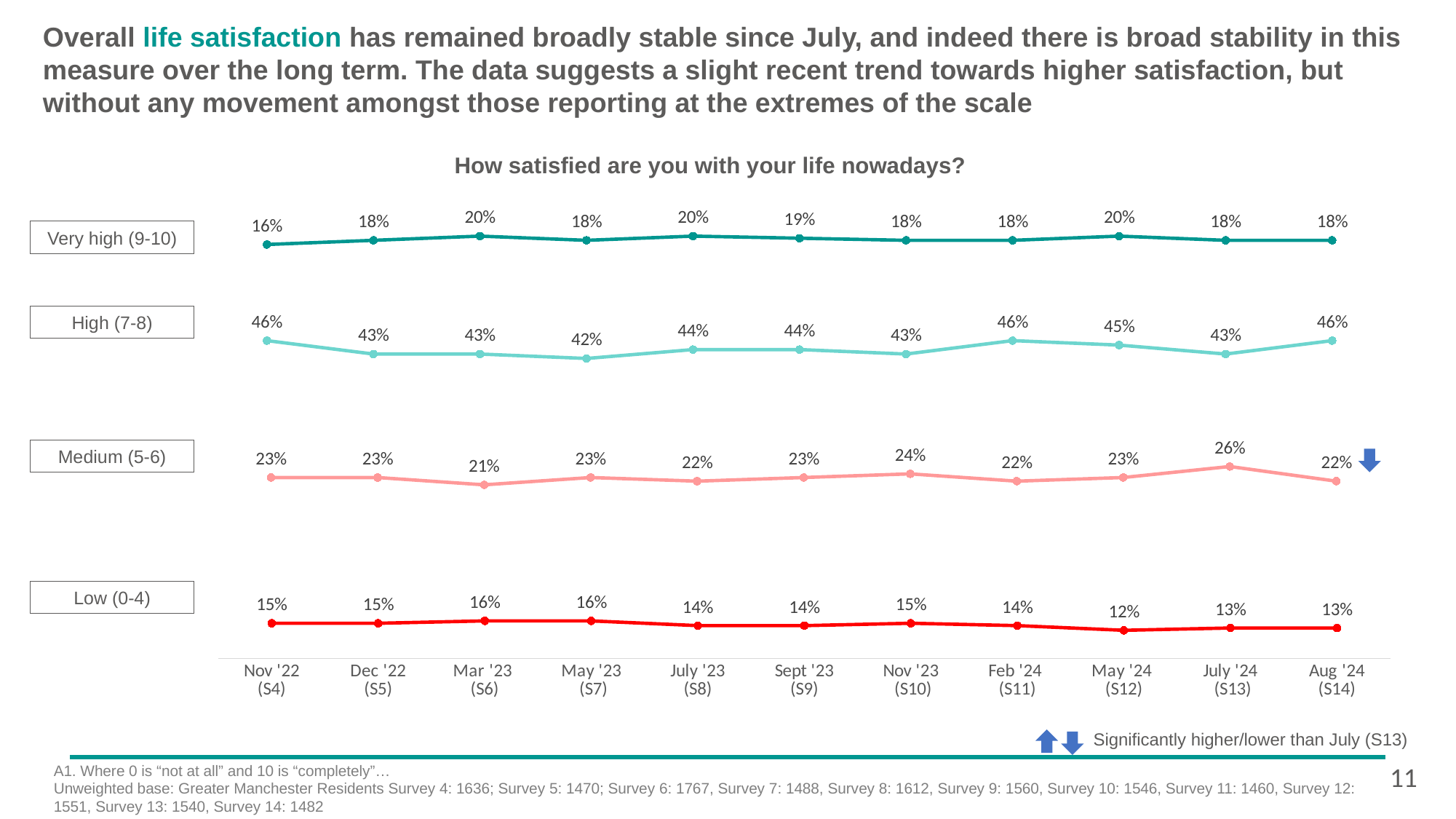
What is the value for Very high (9-10) in Nov '22 (S4)? 16% What is the value for High (7-8) in Aug '24 (S14)? 46% What is the difference between the Medium (5-6) values in July '24 (S13) and Aug '24 (S14)? 4 percentage points What type of chart is shown on the slide? Line chart In which survey wave is the Very high (9-10) value lowest? Nov '22 (S4) What is the value for Low (0-4) in May '24 (S12)? 12% What is the value for Medium (5-6) in July '24 (S13)? 26% How many series (satisfaction bands) are plotted on the chart? 4 Which is larger for High (7-8): the value in Nov '22 (S4) or in Dec '22 (S5)? Nov '22 (S4) How many survey waves are shown on the x axis? 11 In which survey wave is the Low (0-4) value lowest? May '24 (S12) In which survey wave is the Medium (5-6) value highest? July '24 (S13)